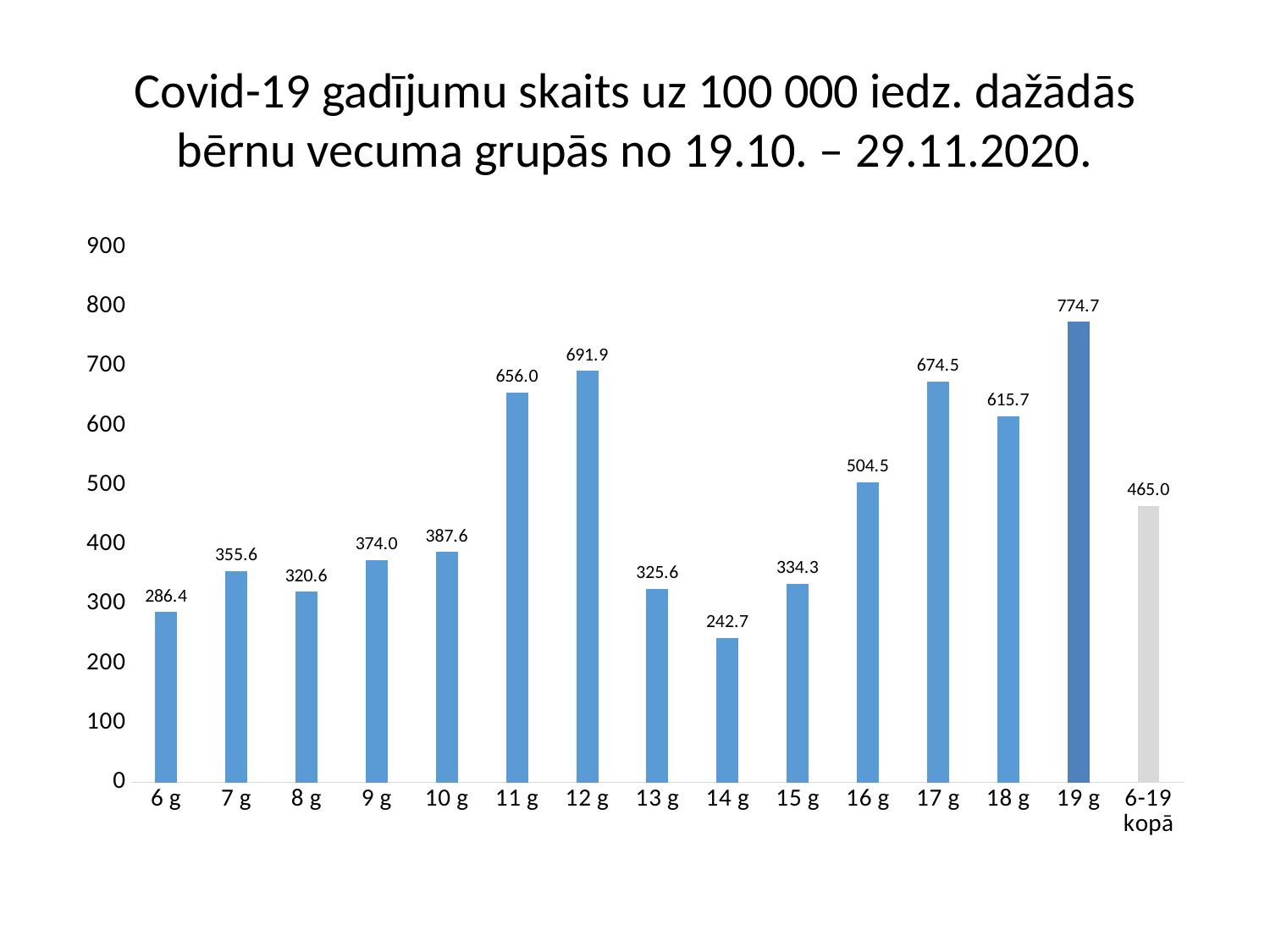
Which age group has the highest value? 19 g Which bar is shown in grey rather than blue? 6-19 kopā What is the value for the 6-19 kopā bar? 465.0 Which is larger, the value for 11 g or the value for 17 g? 17 g What is the difference between the values for 19 g and 18 g? 159.0 Which age group has the lowest value? 14 g How many bars are shown in the chart? 15 What is the value for the 14 g age group? 242.7 What is the value for the 12 g age group? 691.9 What kind of chart is shown on the slide? bar chart Is the value for 16 g greater or less than 500? greater